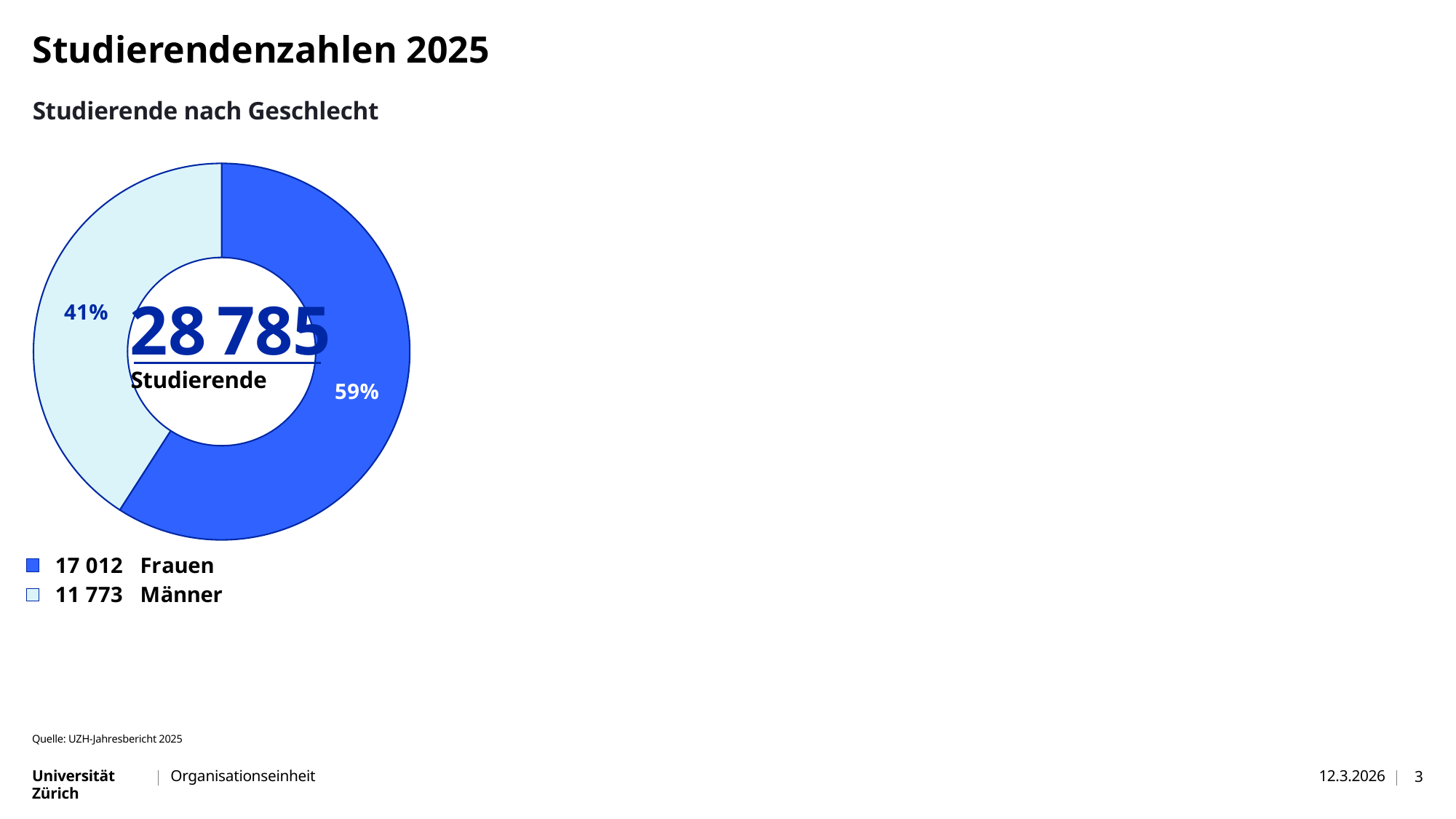
How many Frauen are listed in the legend? 17 012 How many students (Studierende) are shown in the centre of the chart? 28 785 Which category is the smallest in the chart? Männer What is the title of the chart? Studierende nach Geschlecht What is the difference between the number of Frauen and the number of Männer? 5 239 How many categories does the chart show? 2 Which category has the larger value, Frauen or Männer? Frauen What share of the chart do Männer make up? 41% How many Männer are listed in the legend? 11 773 Which colour represents Männer in the chart? Light blue What kind of chart is shown on the slide? Doughnut (pie) chart What share of the chart do Frauen make up? 59%